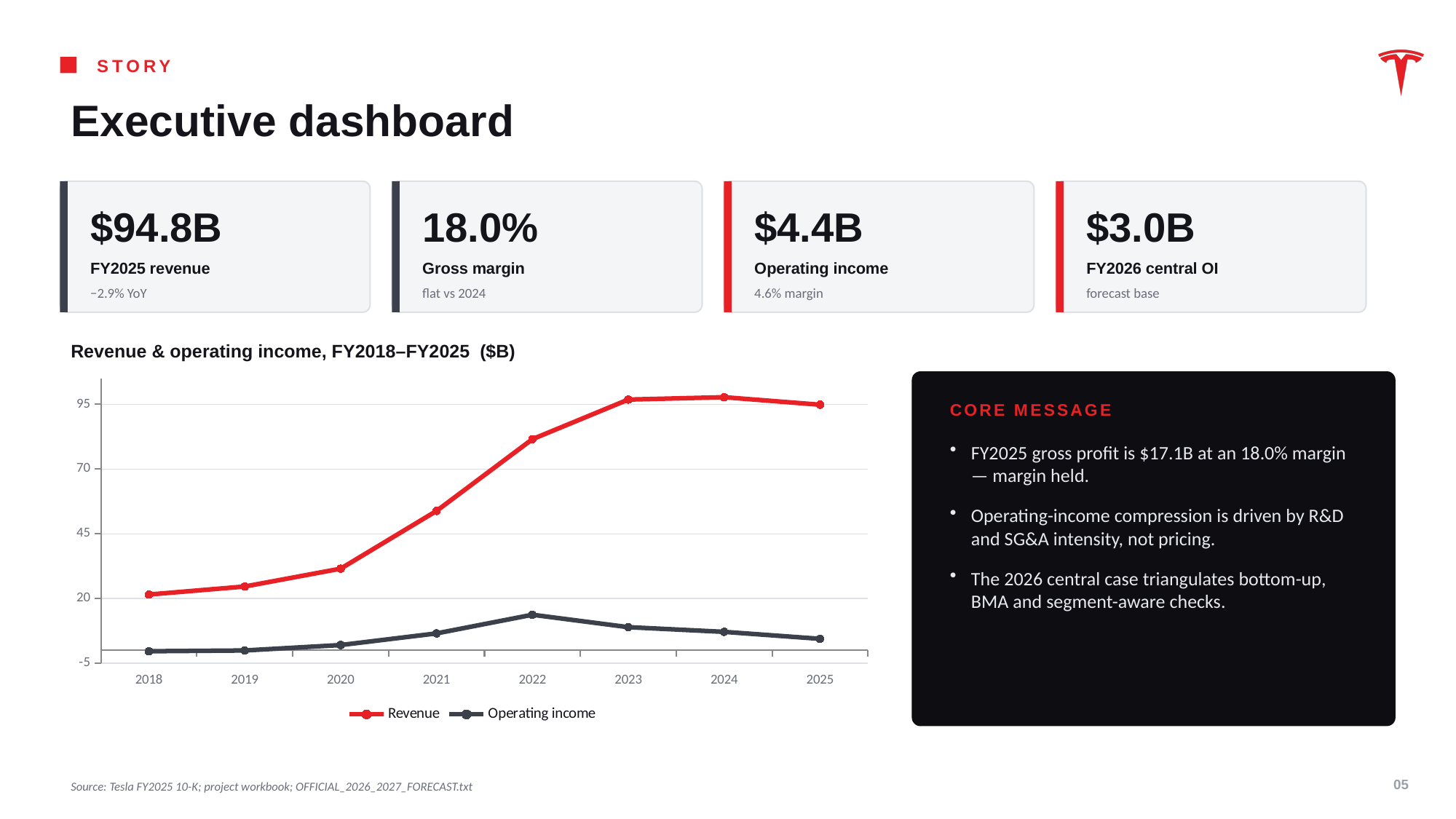
How many series does the chart legend list? 2 Is the Revenue value for 2022 greater or less than 70? greater In which year does Operating income reach its highest point on the chart? 2022 What is the title of the chart? Revenue & operating income, FY2018–FY2025 ($B) What kind of chart is shown on the slide? Line chart Which is larger on the chart: Operating income in 2022 or Operating income in 2025? Operating income in 2022 Which is larger on the chart: Revenue in 2021 or Revenue in 2022? Revenue in 2022 How does Operating income move from 2022 to 2025 on the chart? It falls How many years are plotted along the x axis of the chart? 8 Is the Operating income value for 2022 greater or less than 20? less Is the Revenue value for 2021 greater or less than 45? greater In which year is Revenue lowest on the chart? 2018